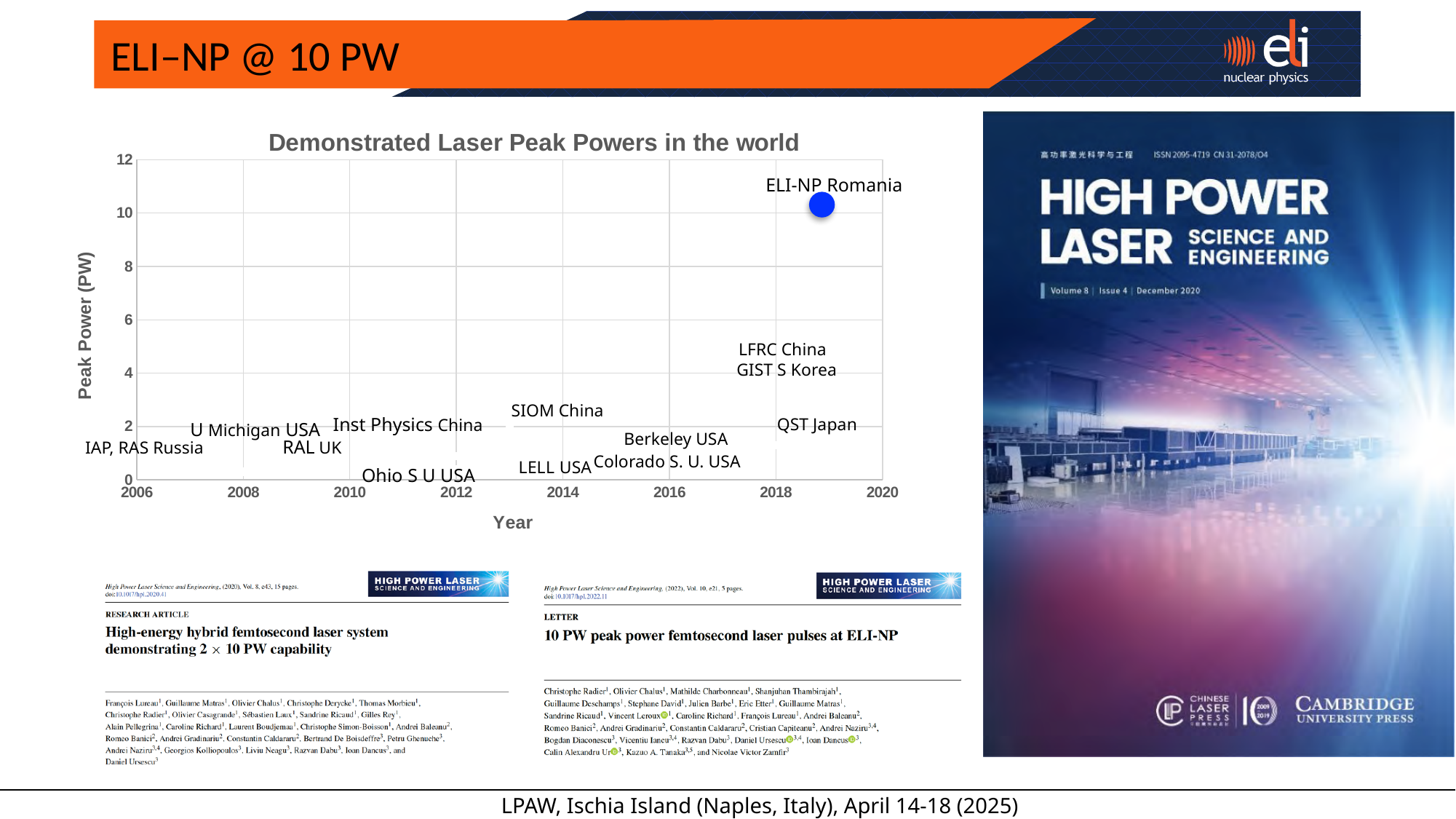
Is the peak power plotted for IAP, RAS Russia greater or less than 4 PW? less Is the peak power plotted for ELI-NP Romania greater or less than 6 PW? greater What kind of chart is shown on the slide? scatter chart Which has the higher peak power in the chart, LFRC China or Ohio S U USA? LFRC China What is the title of the chart? Demonstrated Laser Peak Powers in the world What is the label of the vertical axis of the chart? Peak Power (PW) Is the peak power plotted for ELI-NP Romania greater or less than 12 PW? less How many facilities are labelled in the chart? 13 Which has the higher peak power in the chart, ELI-NP Romania or QST Japan? ELI-NP Romania Which facility has the highest demonstrated laser peak power in the chart? ELI-NP Romania